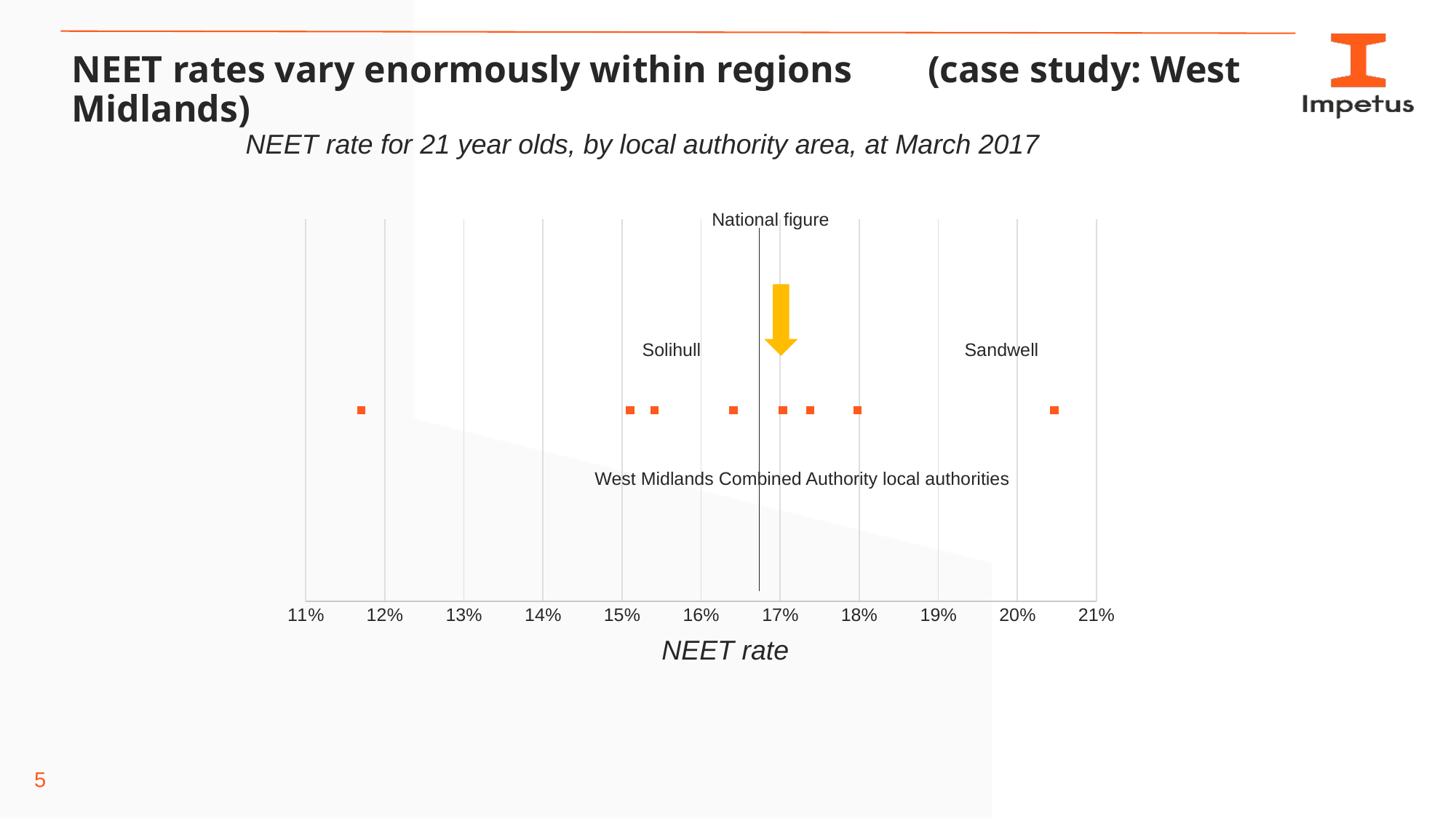
Is the NEET rate for Sandwell greater or less than 20%? greater Is the national figure marked on the chart greater or less than 16%? greater Which labelled local authority has the highest NEET rate on the chart? Sandwell What kind of chart is shown on the slide? Scatter (dot) plot Is the highest plotted NEET rate greater or less than 21%? less What is the title of the chart? NEET rate for 21 year olds, by local authority area, at March 2017 What is the label of the horizontal axis? NEET rate How many local authority data points are plotted on the chart? 8 Which labelled local authority has the higher NEET rate, Solihull or Sandwell? Sandwell